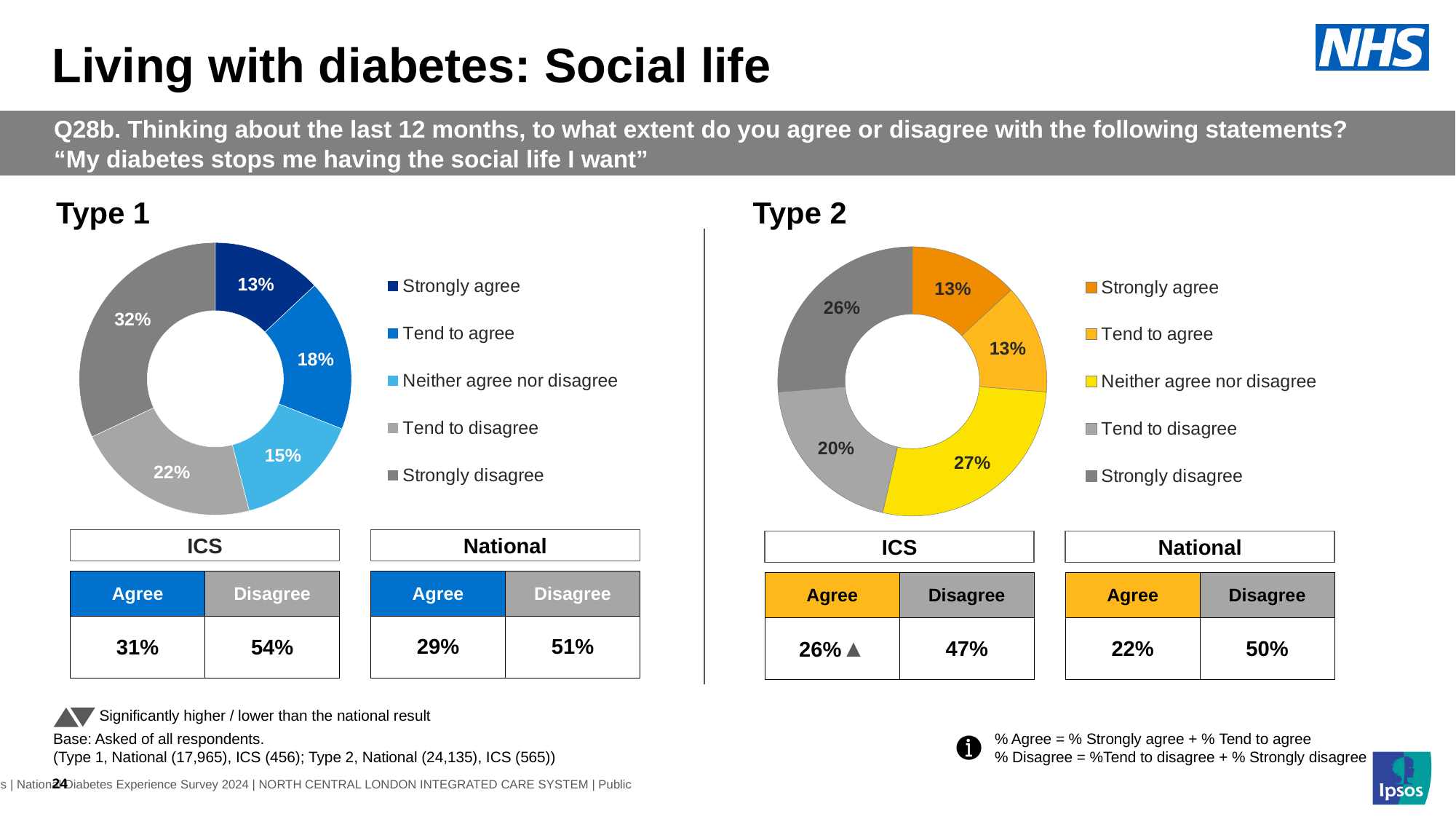
In the Type 2 chart, what percentage of respondents said 'Tend to disagree'? 20% In the Type 2 chart, which response category has the largest share? Neither agree nor disagree What kind of chart is used for the Type 1 data? Doughnut chart In the Type 1 chart, what colour represents 'Strongly agree'? Dark blue In the Type 1 chart, what percentage of respondents said 'Tend to agree'? 18% In the Type 1 chart, what is the difference between the 'Strongly disagree' and 'Tend to disagree' shares? 10 percentage points In the Type 1 chart, which response category has the largest share? Strongly disagree In the Type 2 chart, which is larger: 'Strongly disagree' or 'Tend to disagree'? Strongly disagree In the Type 1 chart, which response category has the smallest share? Strongly agree In the Type 2 chart, what percentage of respondents said 'Neither agree nor disagree'? 27% How many response categories does the Type 2 chart's legend list? 5 In the Type 1 chart, what percentage of respondents said 'Strongly disagree'? 32%